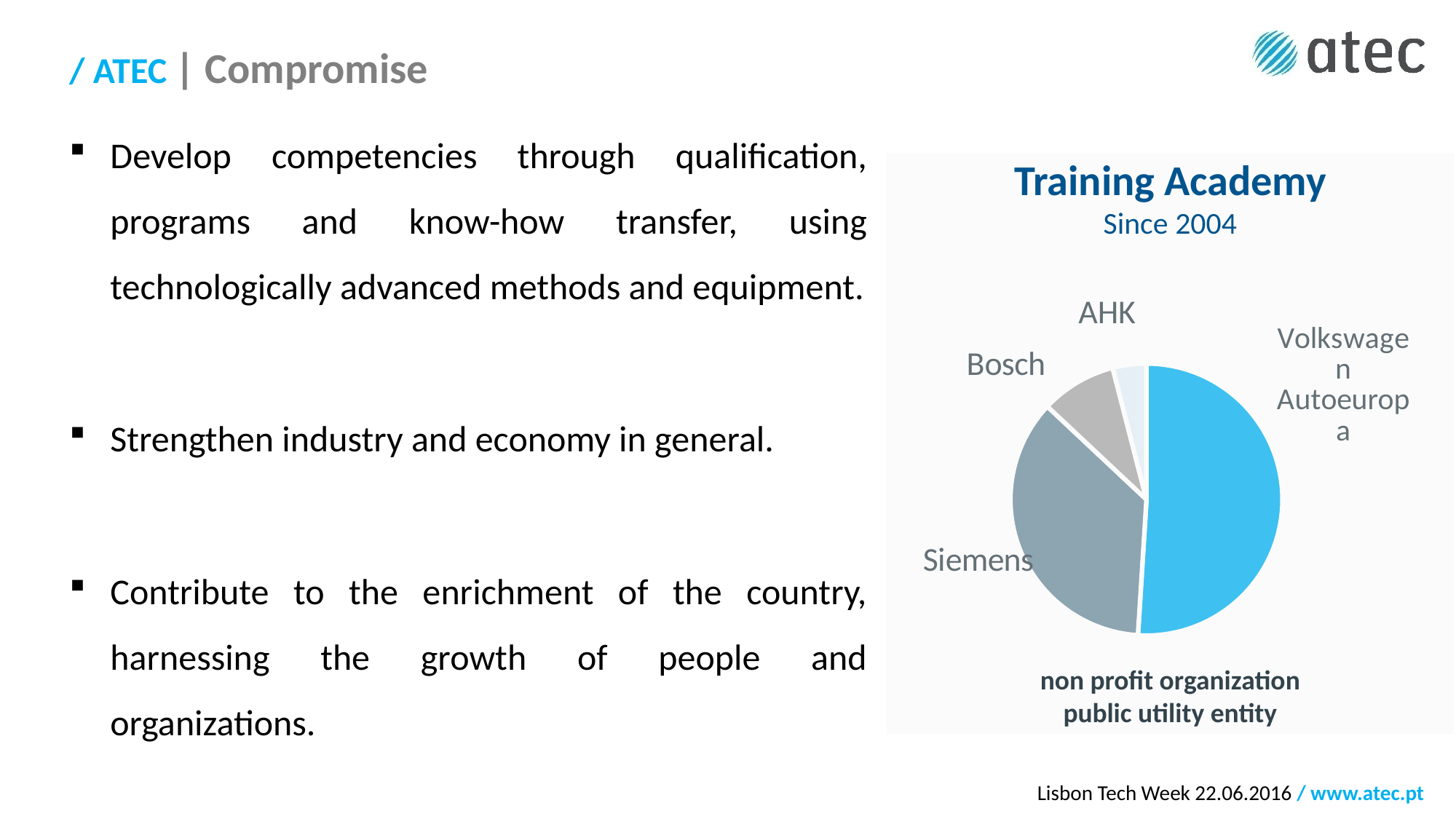
What colour is the Volkswagen Autoeuropa slice? Blue Which slice is larger, Volkswagen Autoeuropa or Siemens? Volkswagen Autoeuropa Which slice is larger, Siemens or Bosch? Siemens What kind of chart is shown on the slide? Pie chart What is the title of the chart? Training Academy Which slice is larger, Bosch or AHK? Bosch How many slices does the pie chart have? 4 Which category has the largest slice of the pie chart? Volkswagen Autoeuropa Which category has the smallest slice of the pie chart? AHK Which category has the second-largest slice of the pie chart? Siemens